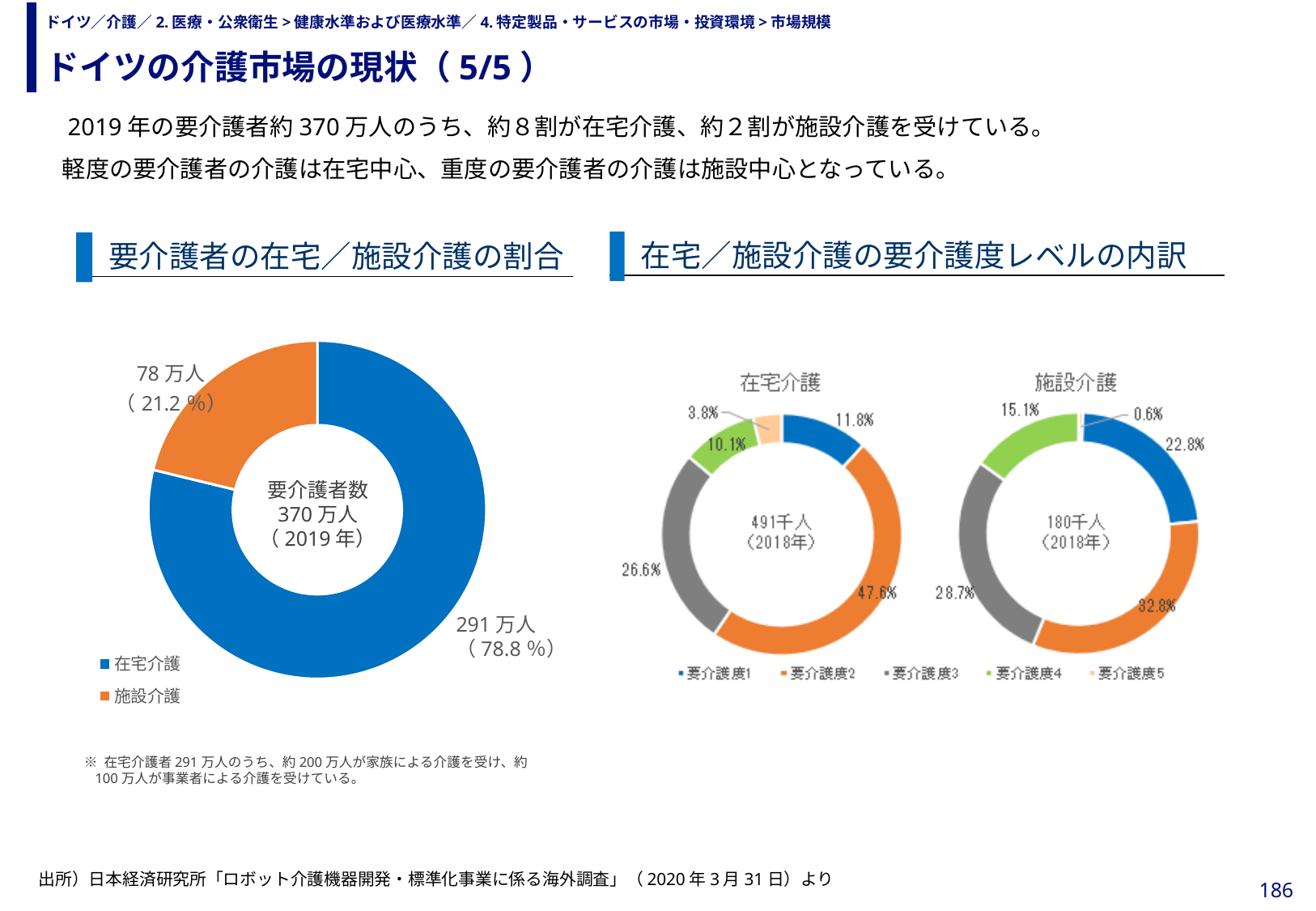
In the 在宅介護 donut on the right side of the slide, which care level has the smallest share? 要介護度5 What kind of chart is the chart titled 要介護者の在宅／施設介護の割合? Donut (pie) chart In the 在宅介護 donut on the right side of the slide, what total number of people is shown in the centre? 491千人 In the chart titled 要介護者の在宅／施設介護の割合, what total number of care recipients is shown in the centre of the donut? 370万人 How many care levels does the legend list for the charts titled 在宅／施設介護の要介護度レベルの内訳? 5 In the 在宅介護 donut on the right side of the slide, what share is 要介護度2? 47.6% In the 施設介護 donut on the right side of the slide, what share is 要介護度1? 22.8% In the chart titled 要介護者の在宅／施設介護の割合, how many people receive 施設介護? 78万人 In the chart titled 要介護者の在宅／施設介護の割合, which category has the larger share, 在宅介護 or 施設介護? 在宅介護 In the 施設介護 donut on the right side of the slide, which care level has the largest share? 要介護度2 In the chart titled 要介護者の在宅／施設介護の割合, what share of care recipients receive 在宅介護? 78.8% In the 施設介護 donut on the right side of the slide, what is the difference between the shares of 要介護度2 and 要介護度3? 4.1%